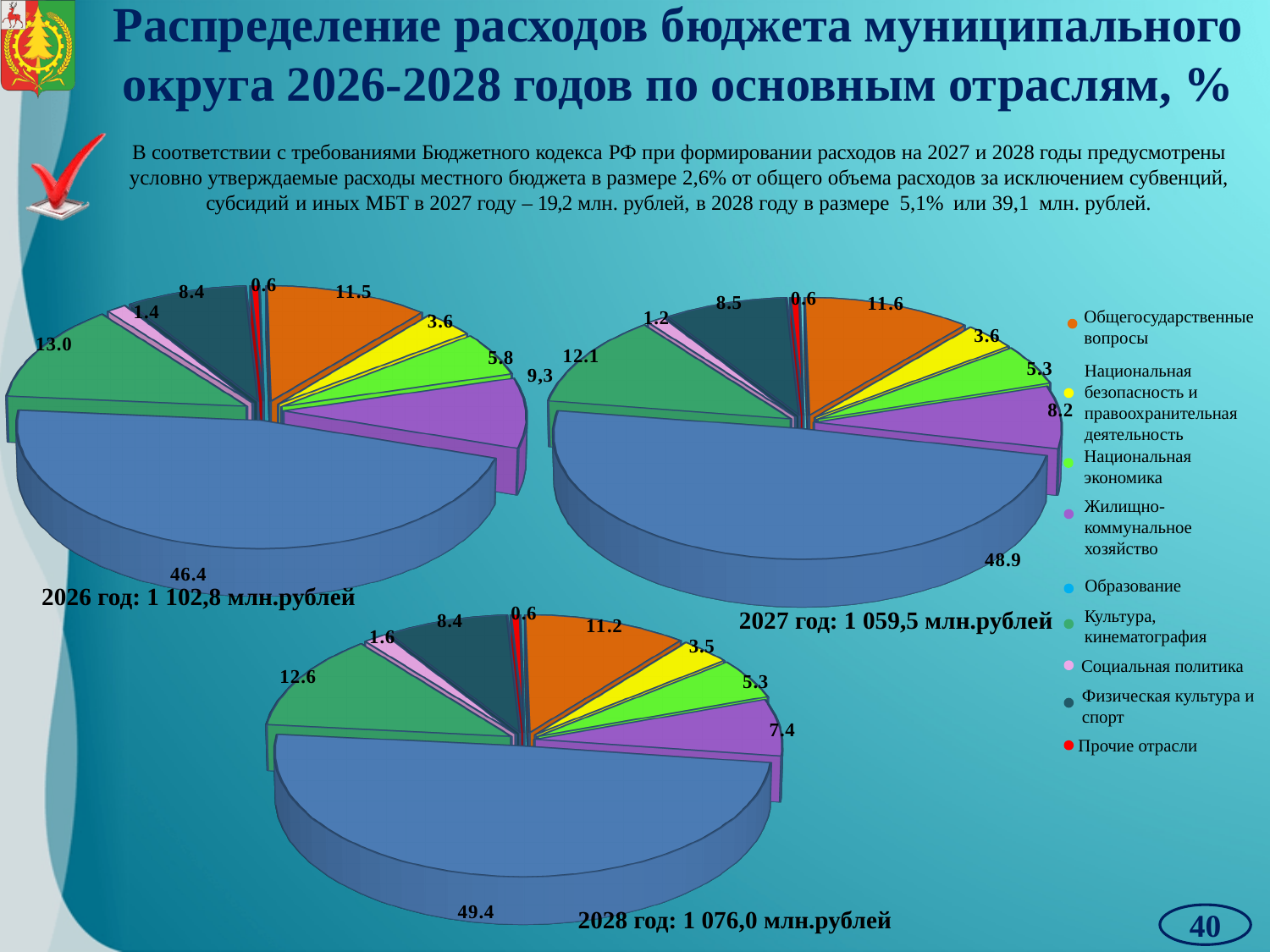
On the 2027 pie chart, what share is shown for Культура, кинематография? 12.1 What total budget expenditure is stated for 2027 below its pie chart? 1 059,5 млн.рублей Which colour represents Образование in the legend? Blue On the 2027 pie chart, which is larger: the share for Общегосударственные вопросы or the share for Жилищно-коммунальное хозяйство? Общегосударственные вопросы What kind of charts are shown on the slide? Pie charts On the 2026 pie chart, what share is shown for Образование? 46.4 On the 2028 pie chart, what share is shown for Жилищно-коммунальное хозяйство? 7.4 On the 2028 pie chart, which category has the largest share? Образование On the 2027 pie chart, which category has the smallest share? Прочие отрасли On the 2026 pie chart, what is the difference between the shares for Культура, кинематография and Физическая культура и спорт? 4.6 On the 2028 pie chart, what share is shown for Социальная политика? 1.6 How many categories does the legend list for the pie charts? 9